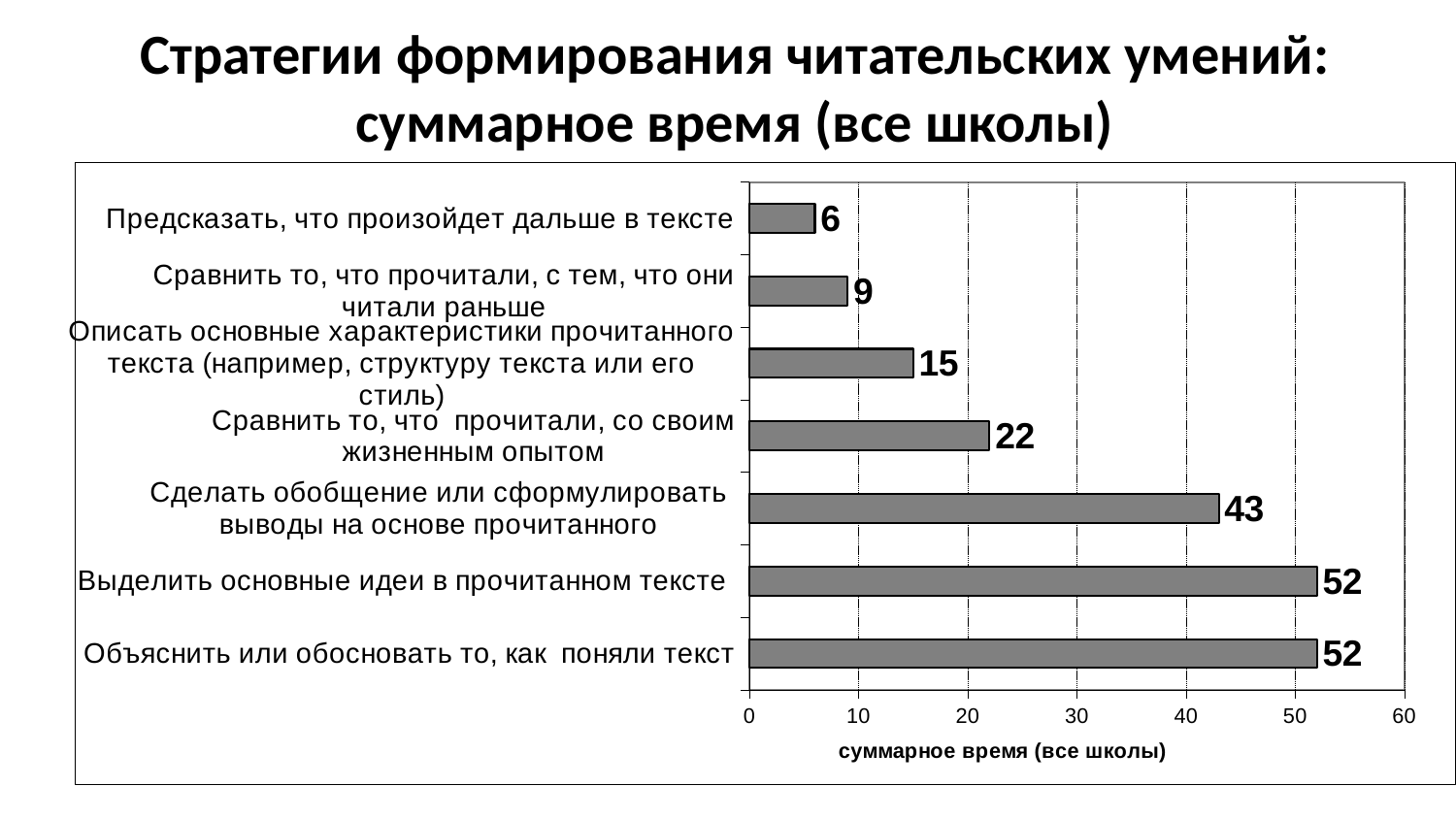
Which is larger: the value for "Сделать обобщение или сформулировать выводы на основе прочитанного" or the value for "Сравнить то, что прочитали, со своим жизненным опытом"? Сделать обобщение или сформулировать выводы на основе прочитанного How many categories are shown in the chart? 7 What is the value for "Сделать обобщение или сформулировать выводы на основе прочитанного"? 43 What is the difference between the values for "Описать основные характеристики прочитанного текста" and "Сравнить то, что прочитали, с тем, что они читали раньше"? 6 What is the value for "Выделить основные идеи в прочитанном тексте"? 52 What is the value for "Предсказать, что произойдет дальше в тексте"? 6 What is the difference between the values for "Сделать обобщение или сформулировать выводы на основе прочитанного" and "Сравнить то, что прочитали, со своим жизненным опытом"? 21 What kind of chart is shown on the slide? bar chart Which category has the lowest value? Предсказать, что произойдет дальше в тексте Is the value for "Объяснить или обосновать то, как поняли текст" greater or less than 50? greater What is the value for "Сравнить то, что прочитали, со своим жизненным опытом"? 22 What is the label of the horizontal axis? суммарное время (все школы)